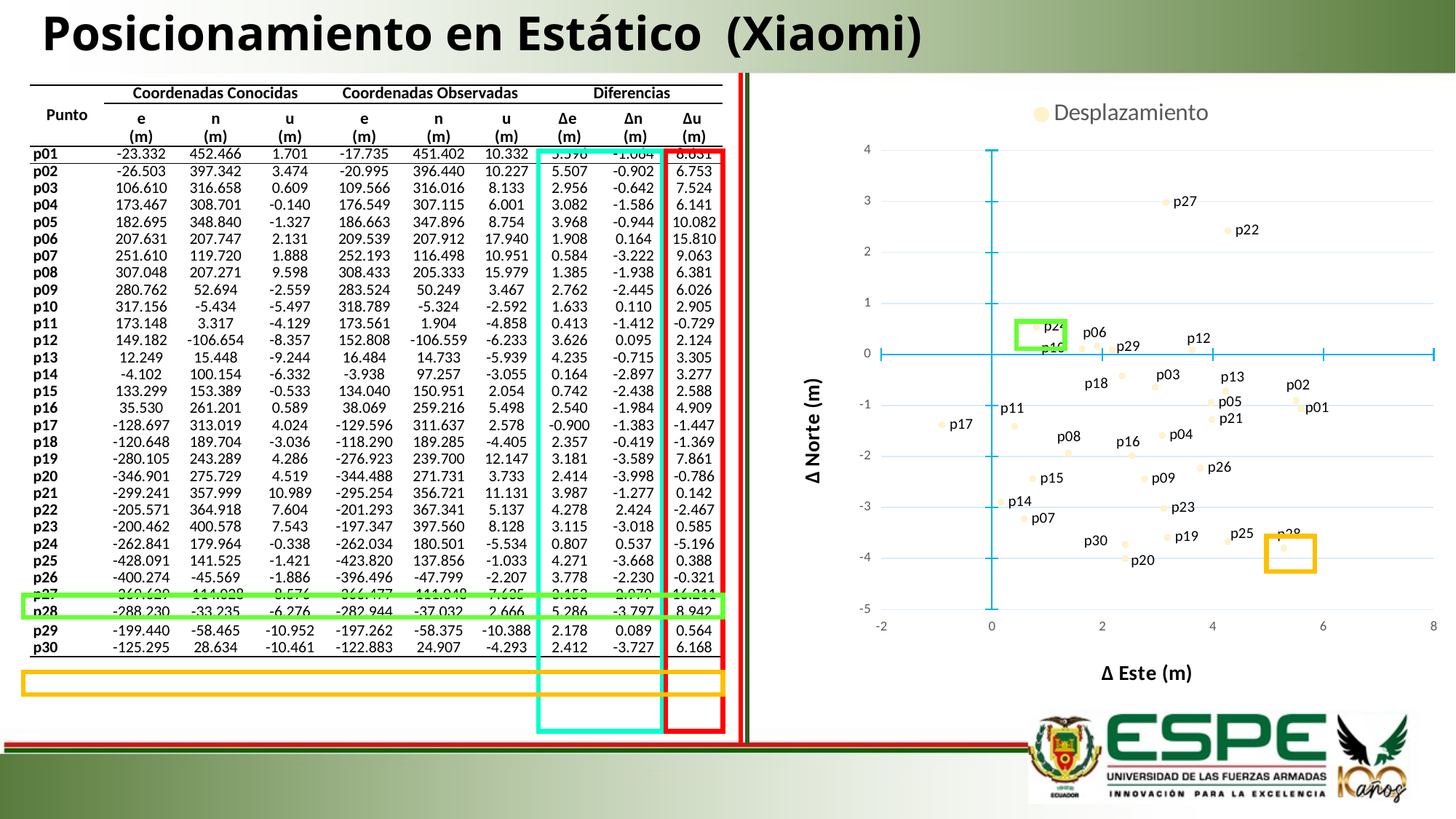
What is the title of the vertical axis of the 'Desplazamiento' chart? Δ Norte (m) What kind of chart is the 'Desplazamiento' chart? scatter chart How many series does the legend of the 'Desplazamiento' chart list? 1 In the 'Desplazamiento' chart, which point has the highest Δ Norte value? p27 In the 'Desplazamiento' chart, which point has the lowest Δ Este value? p17 In the 'Desplazamiento' chart, is the Δ Norte value for p27 greater or less than 2? greater In the 'Desplazamiento' chart, is the Δ Este value for p17 greater or less than 0? less In the 'Desplazamiento' chart, which point has the larger Δ Este value, p17 or p11? p11 What is the title of the horizontal axis of the 'Desplazamiento' chart? Δ Este (m) In the 'Desplazamiento' chart, which point has the larger Δ Norte value, p27 or p22? p27 In the 'Desplazamiento' chart, is the Δ Este value for p01 greater or less than 4? greater